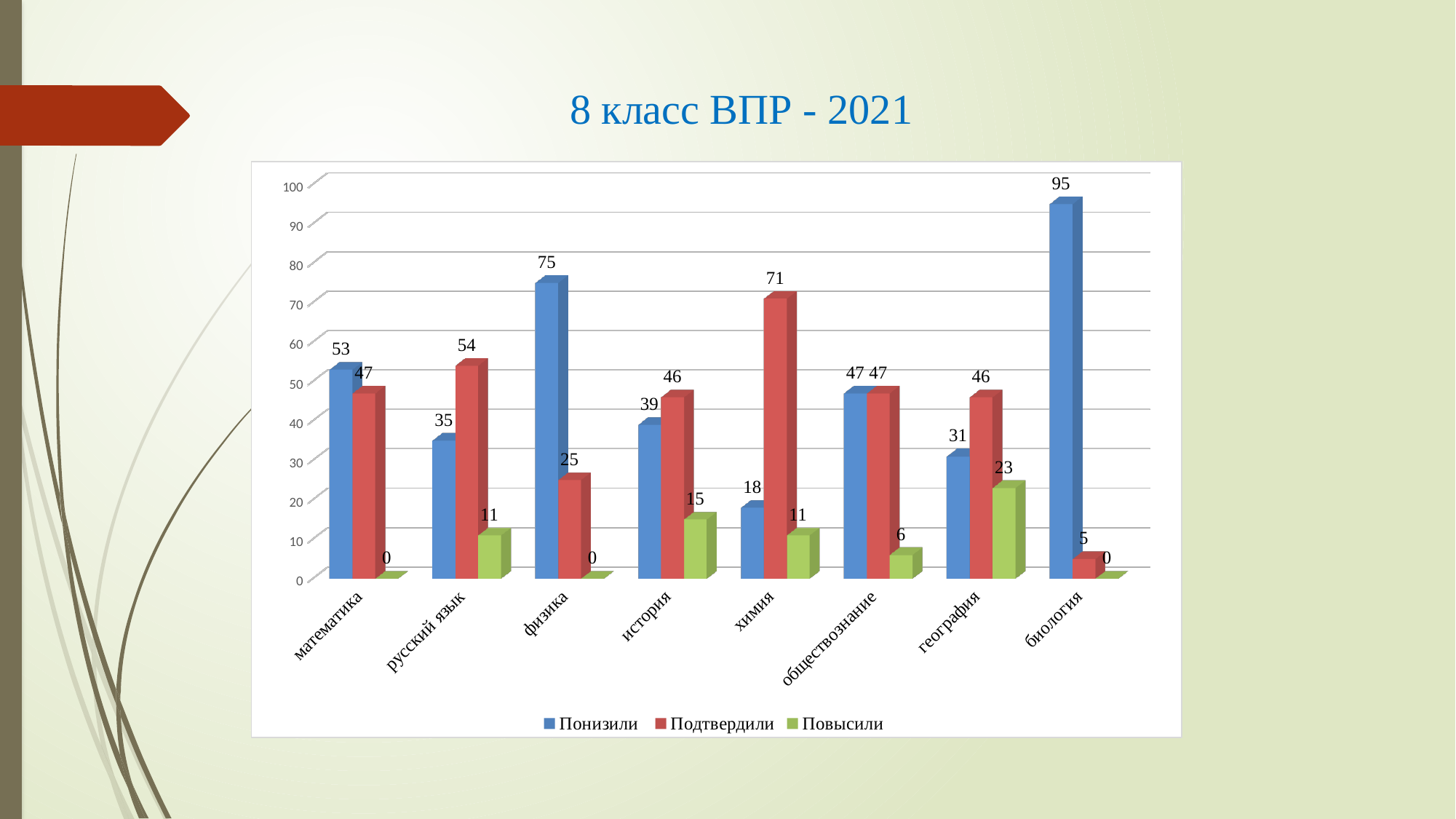
What is the title of the slide? 8 класс ВПР - 2021 What is the value of Подтвердили for химия? 71 Which category has the lowest Понизили value? химия Which is larger for русский язык: Понизили or Подтвердили? Подтвердили What kind of chart is shown on the slide? bar chart How many categories are shown on the x axis? 8 What is the value of Понизили for физика? 75 What is the value of Повысили for география? 23 Which category has the highest Повысили value? география How many series does the legend list? 3 What is the difference between Понизили and Подтвердили for математика? 6 Which category has the highest Понизили value? биология